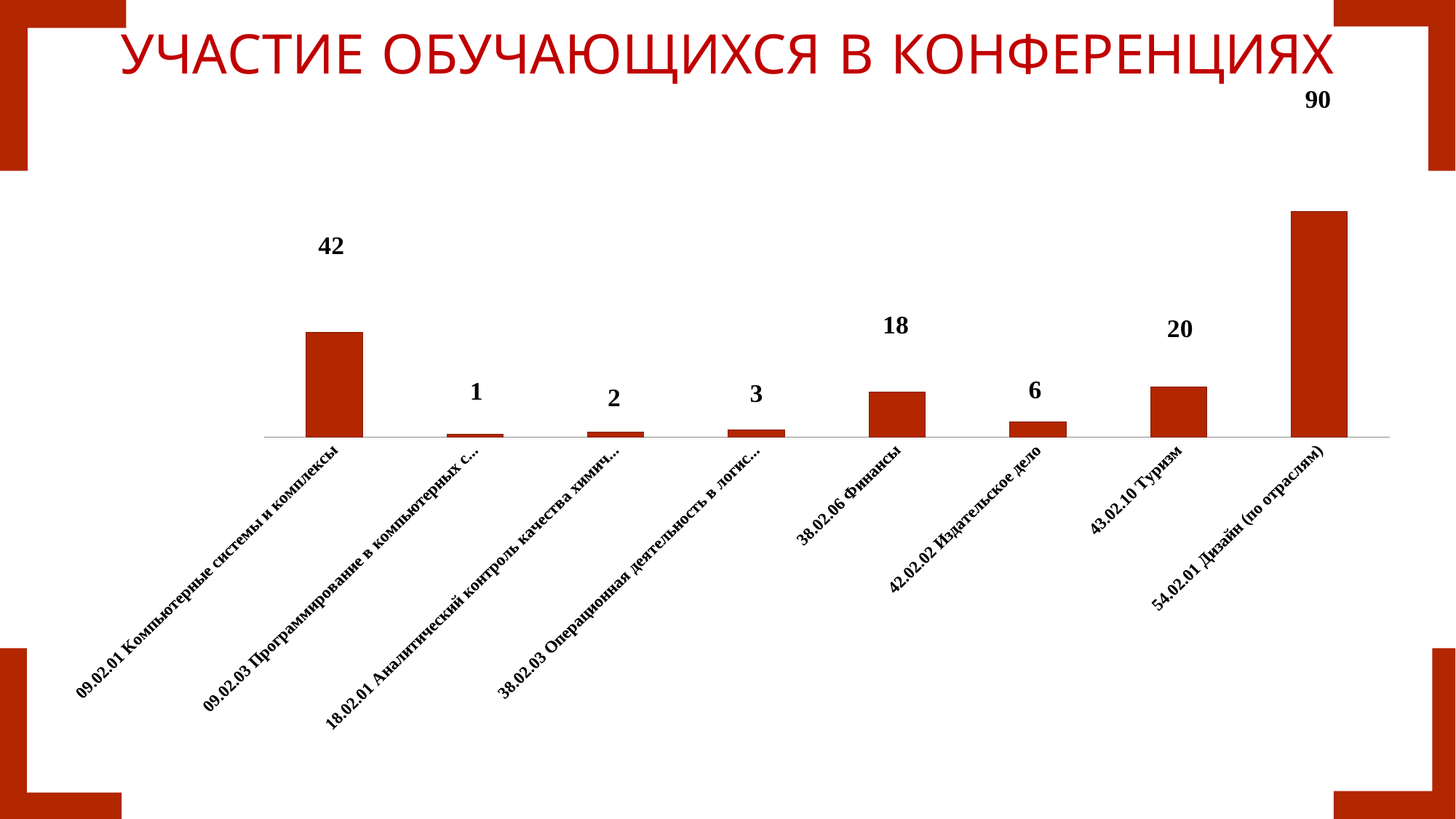
What is the value for 09.02.01 Компьютерные системы и комплексы? 42 What kind of chart is shown on the slide? Bar chart What is the value for 38.02.06 Финансы? 18 What is the value for 42.02.02 Издательское дело? 6 Which is larger, the value for 38.02.06 Финансы or the value for 42.02.02 Издательское дело? 38.02.06 Финансы Which category has the highest value? 54.02.01 Дизайн (по отраслям) What is the value for 43.02.10 Туризм? 20 What is the difference between the values for 54.02.01 Дизайн (по отраслям) and 09.02.01 Компьютерные системы и комплексы? 48 What is the difference between the values for 43.02.10 Туризм and 38.02.06 Финансы? 2 How many categories are shown in the chart? 8 Which category has the lowest value? 09.02.03 Программирование в компьютерных с... What is the title of the slide? УЧАСТИЕ ОБУЧАЮЩИХСЯ В КОНФЕРЕНЦИЯХ